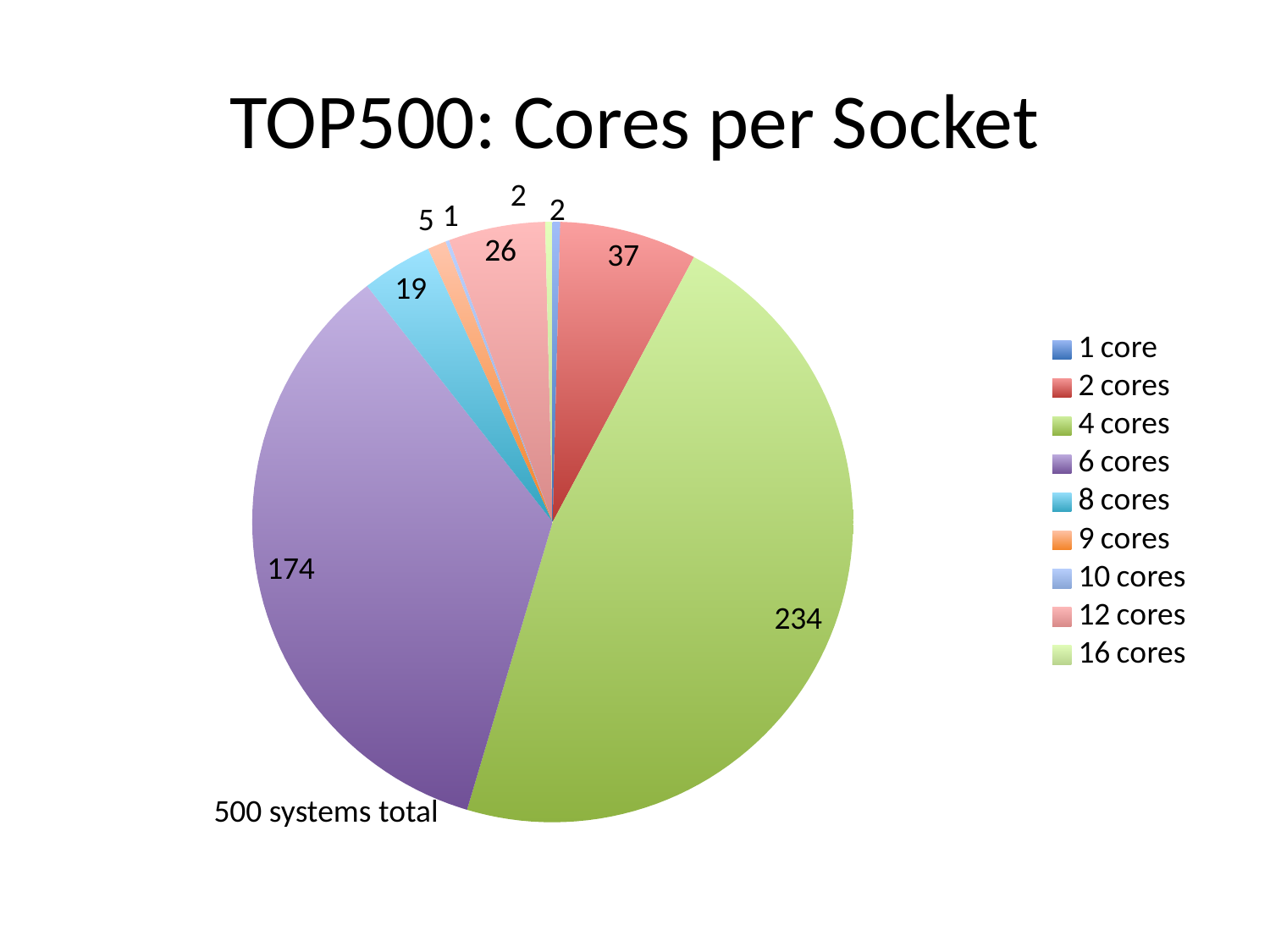
What is the value for the 12 cores slice? 26 What is the value for the 8 cores slice? 19 Which cores-per-socket category has the largest slice? 4 cores What is the difference between the 4 cores and 6 cores values? 60 How many systems have 6 cores per socket? 174 How many systems have 4 cores per socket? 234 Which cores-per-socket category has the smallest slice? 10 cores What share of the 500 systems have 4 cores per socket? 46.8% Which is larger, the 2 cores slice or the 12 cores slice? 2 cores What is the value for the 2 cores slice? 37 What type of chart is shown on the slide? pie chart How many categories does the legend list? 9